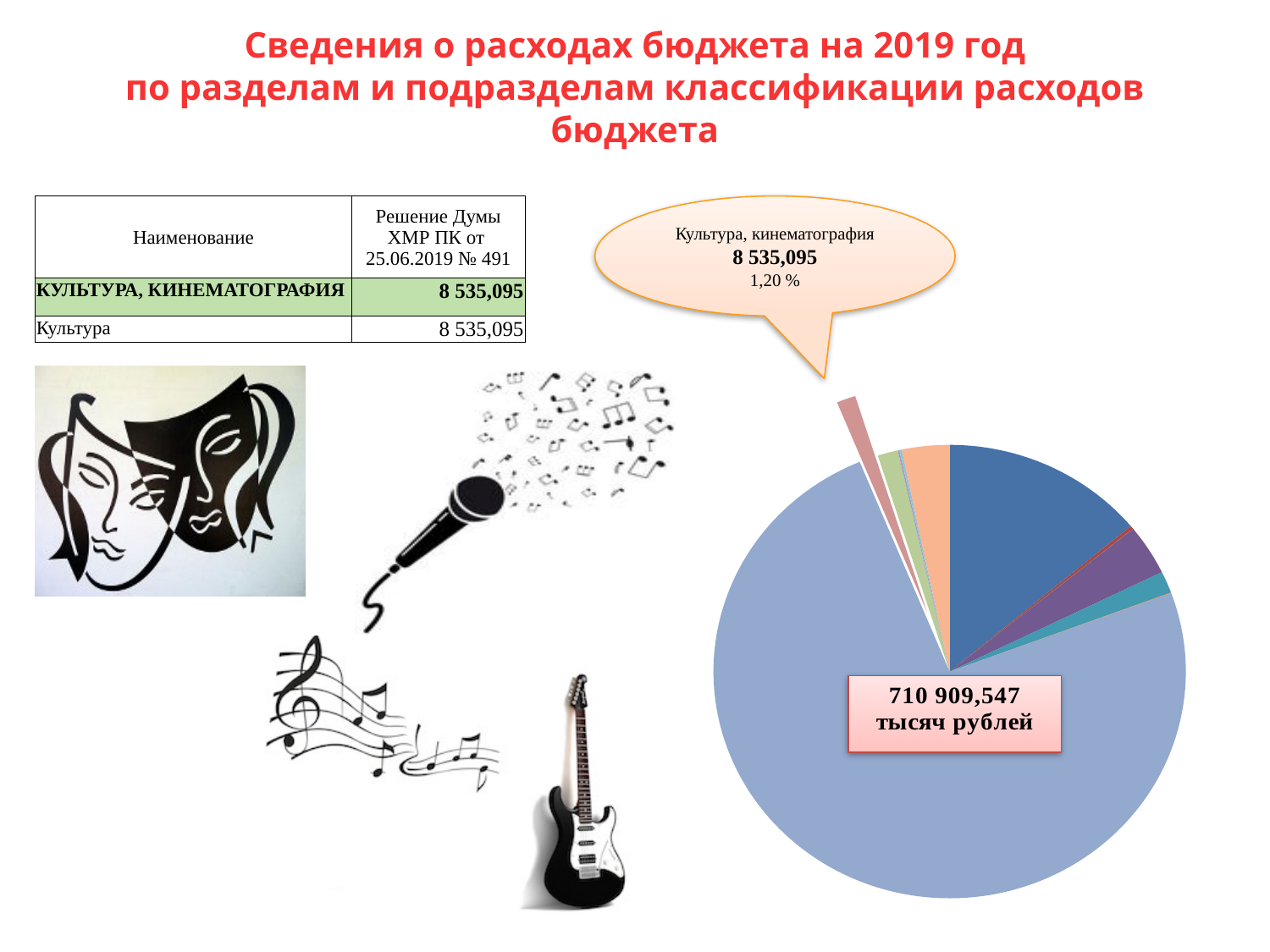
What share of the pie does the Культура, кинематография slice represent, according to the callout? 1,20 % What value does the callout on the pie chart give for Культура, кинематография? 8 535,095 Which category's slice is pulled out from the pie chart? Культура, кинематография Does the pie chart have a legend listing its categories? No Is the share of Культура, кинематография in the pie chart greater or less than 10%? less What total amount is shown in the box on the pie chart? 710 909,547 тысяч рублей What kind of chart is shown on the slide? pie chart